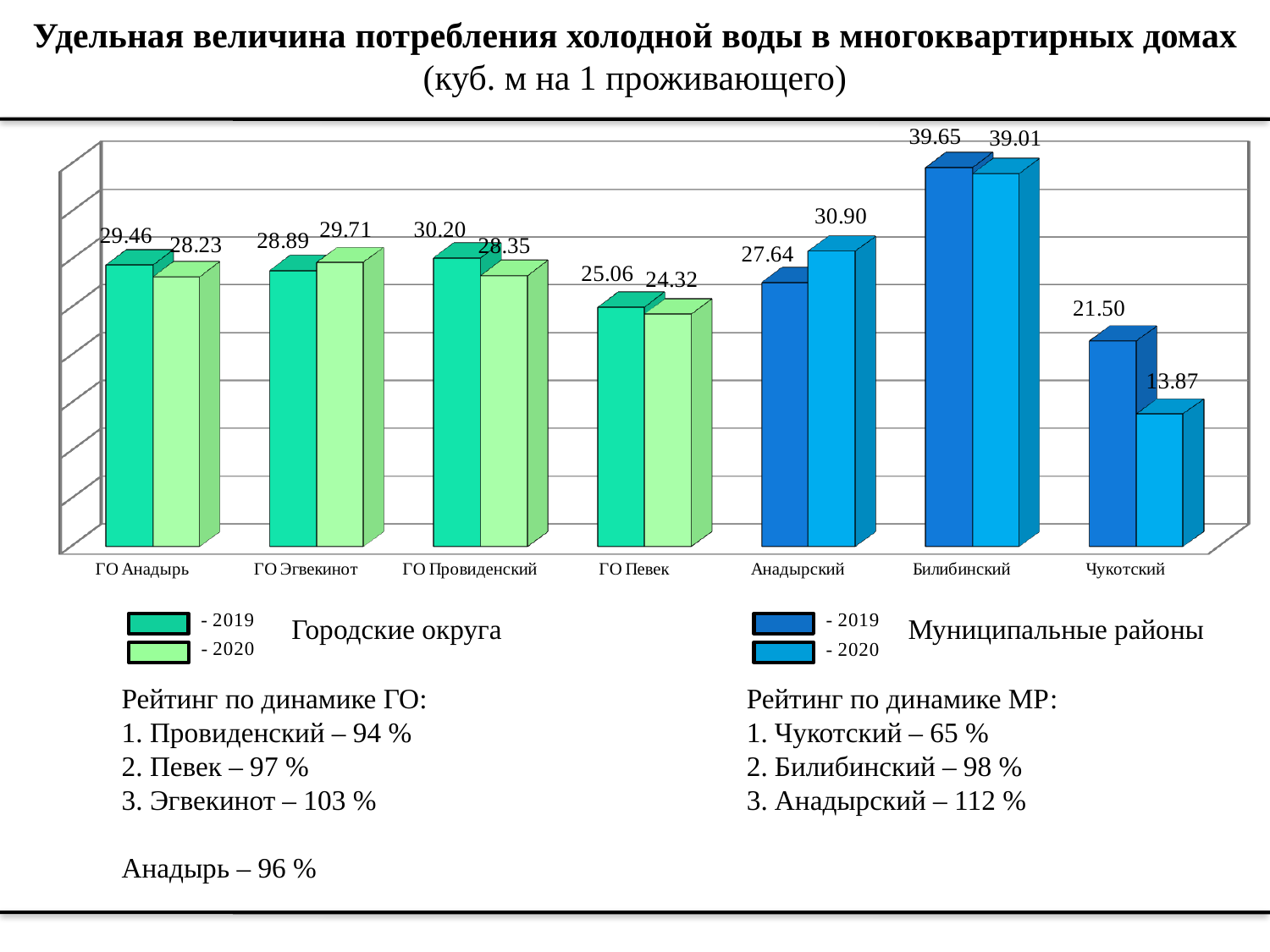
How many categories are shown on the x axis? 7 How many series (years) does the legend list? 2 What is the 2019 value for Билибинский? 39.65 Which is larger for ГО Эгвекинот: the 2019 value or the 2020 value? 2020 What kind of chart is shown on the slide? bar chart What is the 2020 value for Анадырский? 30.90 What is the 2019 value for ГО Певек? 25.06 What is the 2020 value for Чукотский? 13.87 What is the difference between the 2020 and 2019 values for Анадырский? 3.26 What is the difference between the 2019 and 2020 values for Чукотский? 7.63 Which category has the lowest 2020 value? Чукотский Which category has the highest 2019 value? Билибинский